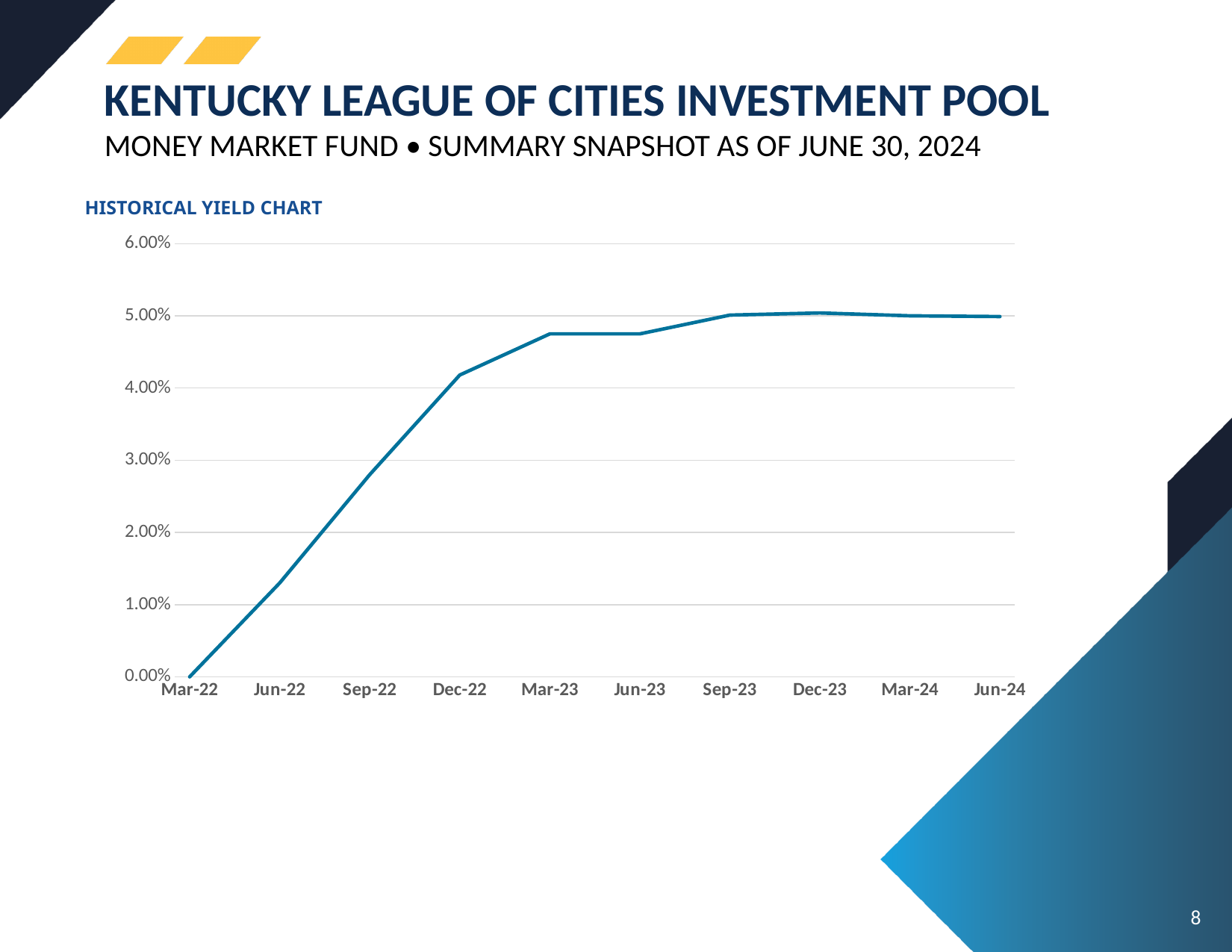
Does the yield generally rise or fall from Mar-22 to Jun-24? rise Is the value for Jun-24 greater or less than 4.00%? greater What is the title of the chart? HISTORICAL YIELD CHART How many data points are plotted along the x axis? 10 Is the value for Sep-22 greater or less than 2.00%? greater What kind of chart is shown on the slide? line chart Which date has the lowest yield? Mar-22 Is the value for Mar-23 greater or less than 5.00%? less What is the highest value shown on the y axis? 6.00% Which is larger, the yield for Jun-22 or the yield for Dec-22? Dec-22